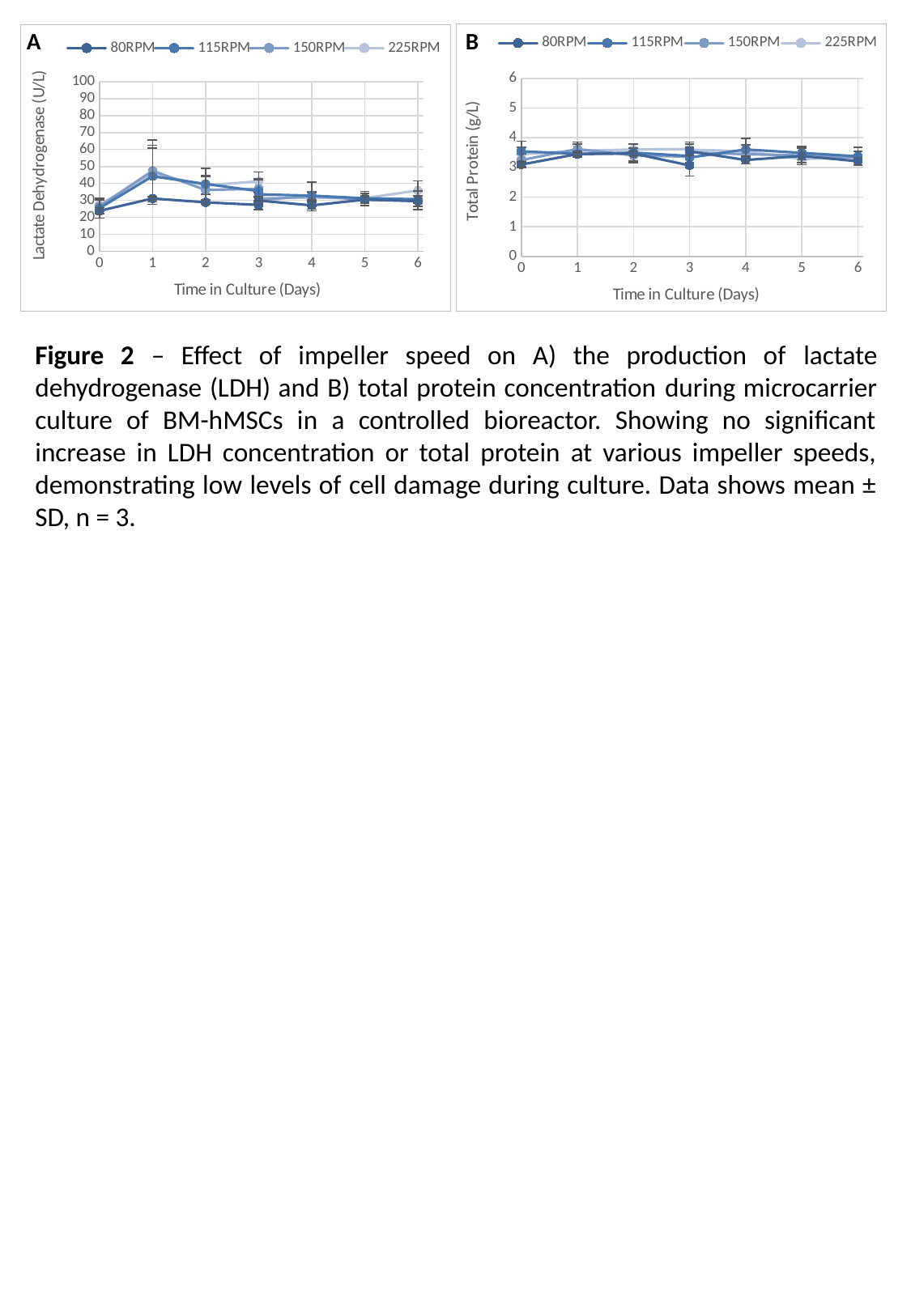
How many series does the legend of chart B (Total Protein) list? 4 What is the y-axis title of chart B? Total Protein (g/L) In chart A (Lactate Dehydrogenase), does the 150RPM series rise or fall from day 1 to day 6? fall What is the x-axis title of chart A? Time in Culture (Days) In chart A (Lactate Dehydrogenase), which series has the lowest value at day 1? 80RPM In chart A (Lactate Dehydrogenase), on which day does the 150RPM series reach its highest value? 1 In chart B (Total Protein), is the value for 80RPM at day 0 greater or less than 2? greater In chart A (Lactate Dehydrogenase), is the value for 150RPM at day 1 greater or less than 40? greater What kind of chart is chart A (Lactate Dehydrogenase)? line chart In chart B (Total Protein), is the value for 225RPM at day 4 greater or less than 5? less